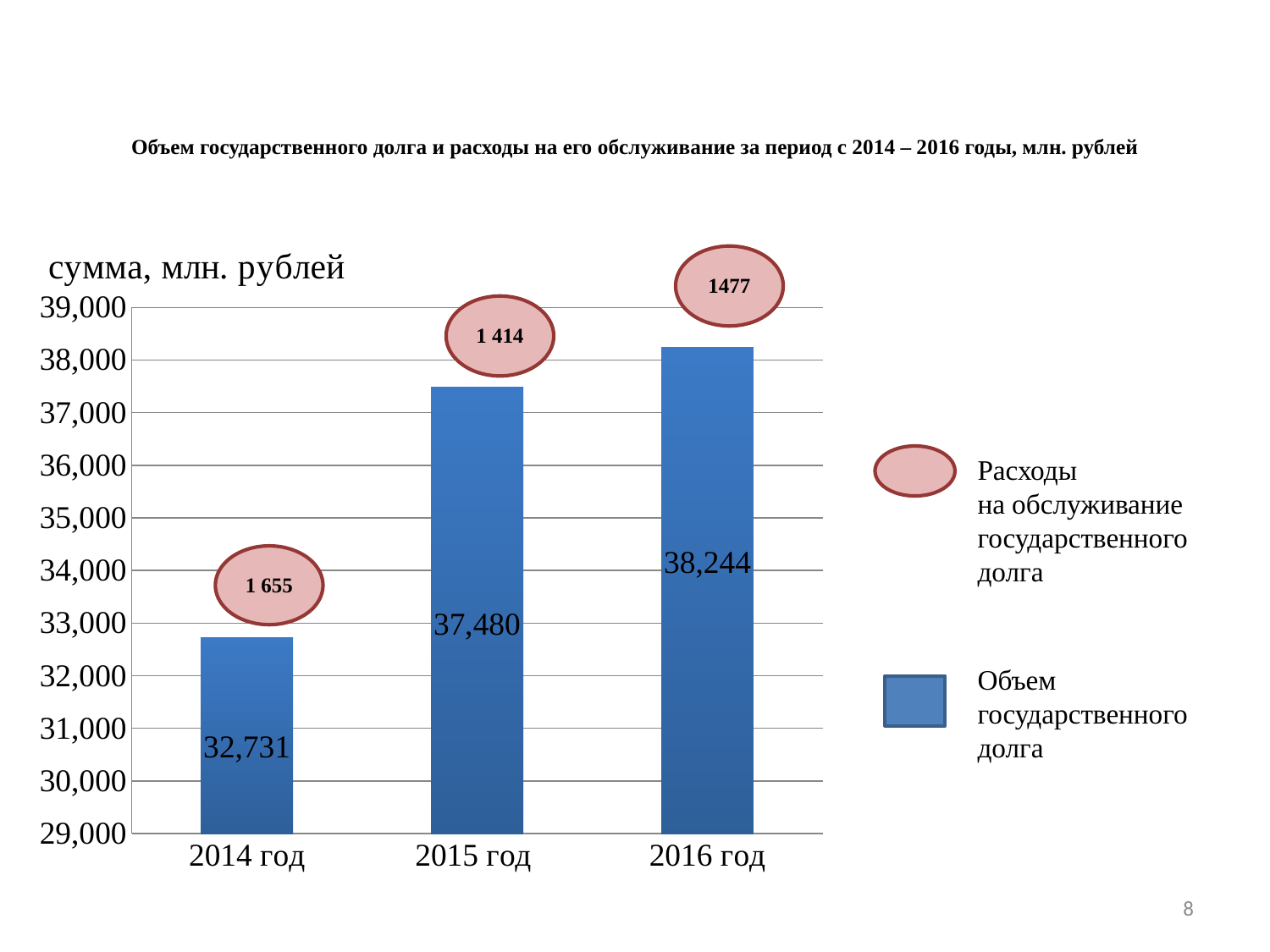
What is the value of the bar for 2015 год? 37,480 How many years are shown on the x axis? 3 What is the value of the bar for 2014 год? 32,731 What value is shown in the oval above the 2014 год bar (расходы на обслуживание государственного долга)? 1 655 What is the difference between the bar values for 2015 год and 2014 год? 4,749 Which is larger: the oval value for 2014 год or the oval value for 2015 год? 2014 год What type of chart is shown on the slide? bar chart What value is shown in the oval above the 2016 год bar (расходы на обслуживание государственного долга)? 1477 Which year has the lowest bar (объем государственного долга)? 2014 год What is the value of the bar for 2016 год? 38,244 Which year has the highest bar (объем государственного долга)? 2016 год Do the bar values rise or fall from 2014 год to 2016 год? rise